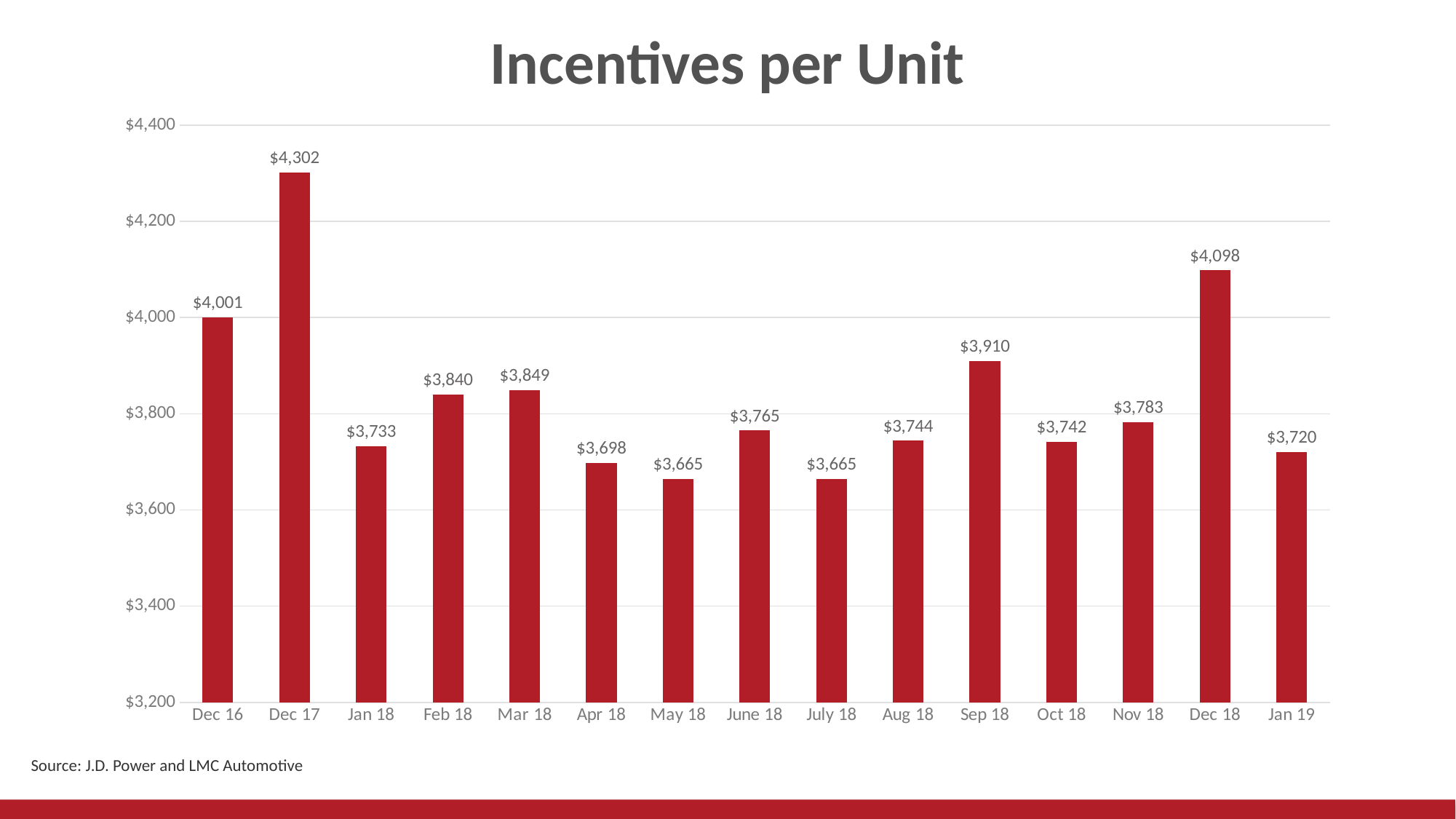
What is the value for Jan 19? $3,720 How many months are shown on the x axis? 15 What is the difference between the values for Dec 18 and Jan 19? $378 Which is larger, the value for Feb 18 or the value for Mar 18? Mar 18 What is the difference between the values for Dec 17 and Dec 16? $301 What is the title of the chart? Incentives per Unit Which is larger, the value for Dec 16 or the value for Dec 18? Dec 18 What kind of chart is this? bar chart Is the value for Nov 18 greater or less than $3,800? less Which month has the highest incentives per unit? Dec 17 What is the value for Sep 18? $3,910 What is the value for Dec 17? $4,302